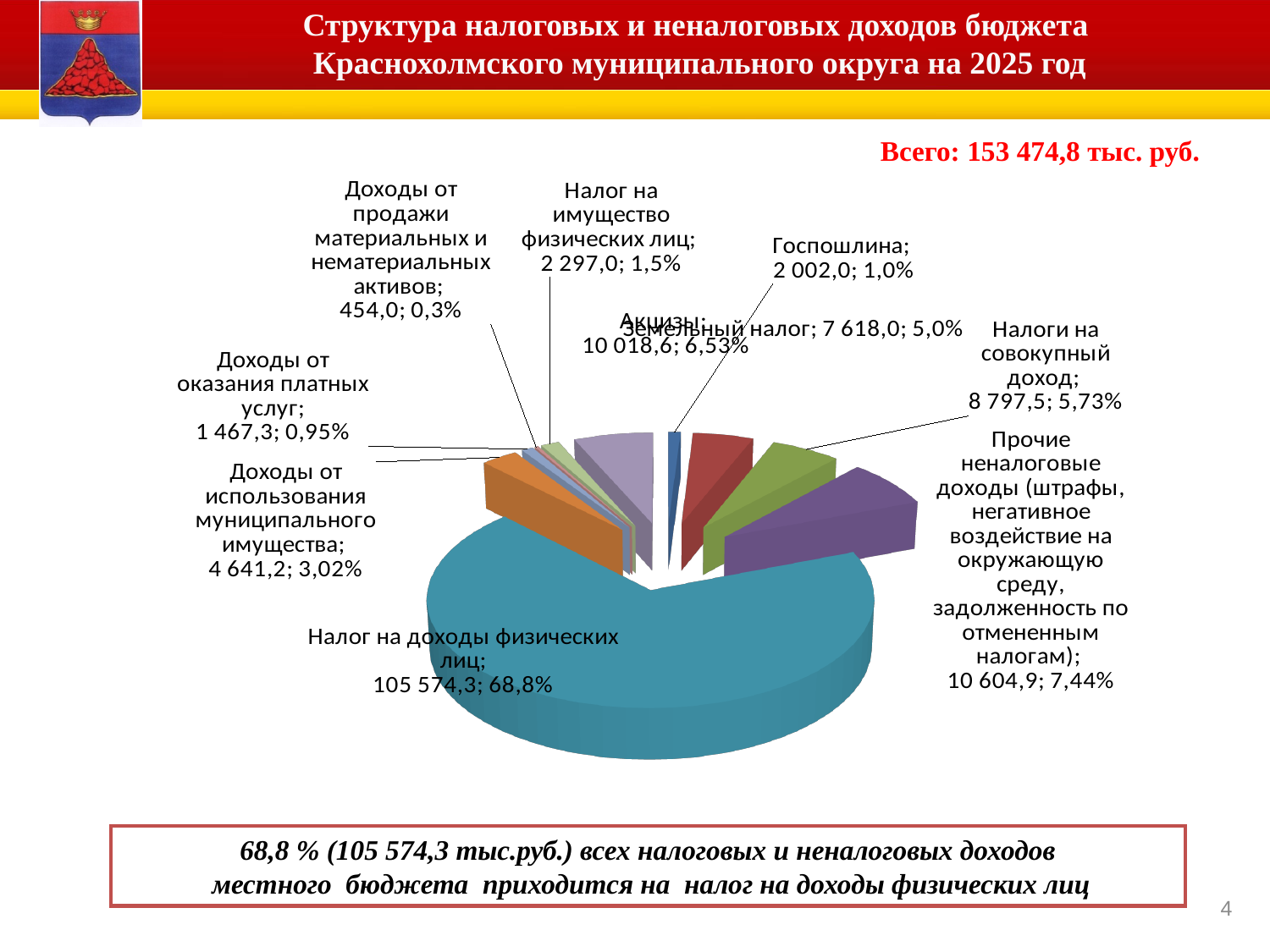
What is the value for Земельный налог? 7 618,0 What share of the pie does Налог на доходы физических лиц represent? 68,8% What is the value for Госпошлина? 2 002,0 What is the value for Акцизы? 10 018,6 How many categories are shown in the pie chart? 10 Which is larger: Налоги на совокупный доход or Земельный налог? Налоги на совокупный доход What share of the pie does Прочие неналоговые доходы represent? 7,44% What is the value for Налог на доходы физических лиц? 105 574,3 Which category has the smallest share of the pie? Доходы от продажи материальных и нематериальных активов What kind of chart is shown on the slide? Pie chart What is the difference between the values for Акцизы and Земельный налог? 2 400,6 Which category has the largest share of the pie? Налог на доходы физических лиц